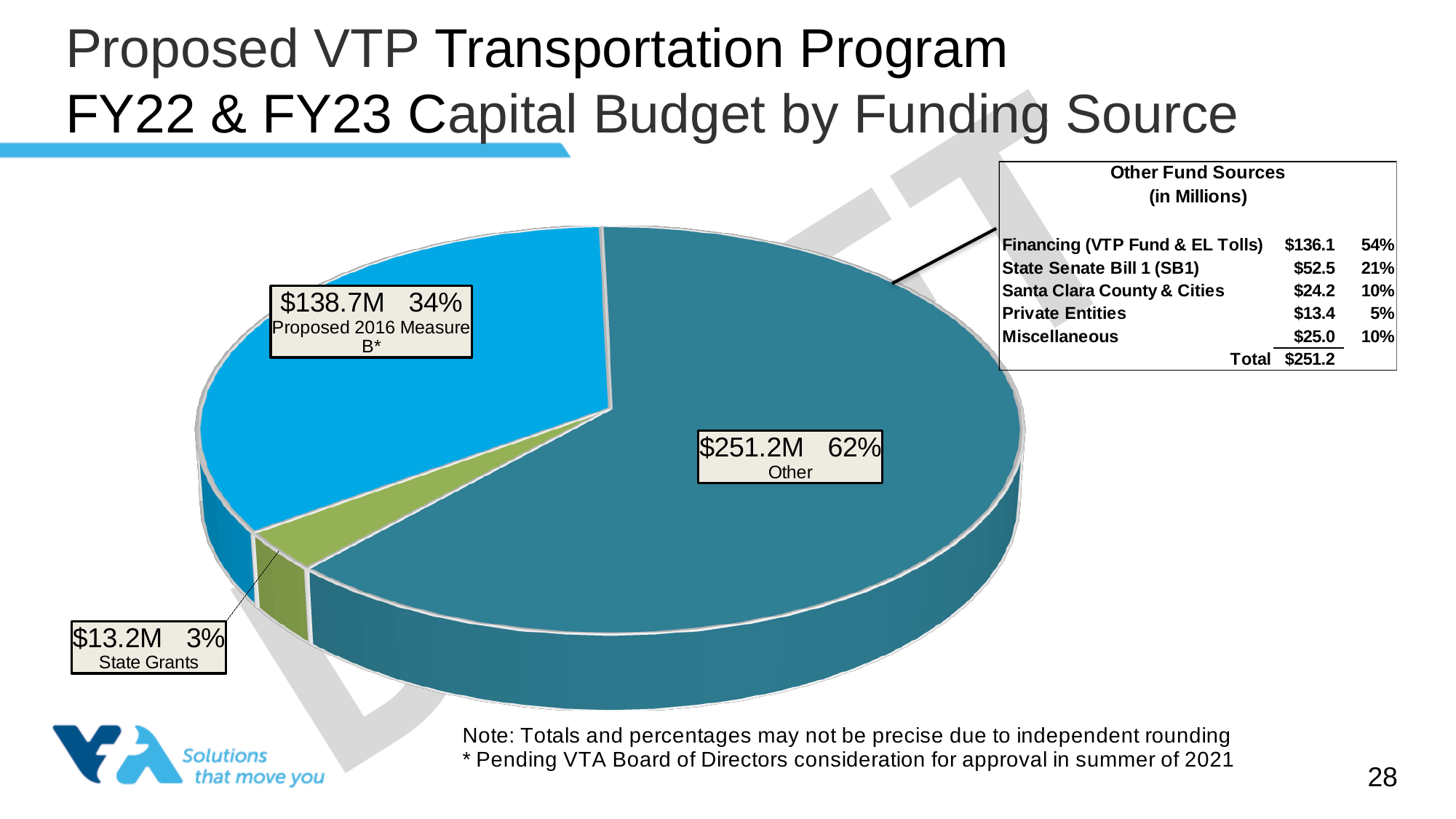
Which is larger, the Proposed 2016 Measure B* slice or the State Grants slice? Proposed 2016 Measure B* What colour is the Other slice? Dark teal blue Which slice is the smallest? State Grants What is the value for the Other slice? $251.2M What kind of chart is shown on the slide? Pie chart What share of the pie does the State Grants slice represent? 3% What is the difference in value between the Other slice and the Proposed 2016 Measure B* slice? $112.5M Which slice is the largest? Other How many slices does the pie chart have? 3 What is the value for the State Grants slice? $13.2M What is the value for the Proposed 2016 Measure B* slice? $138.7M What share of the pie does the Other slice represent? 62%